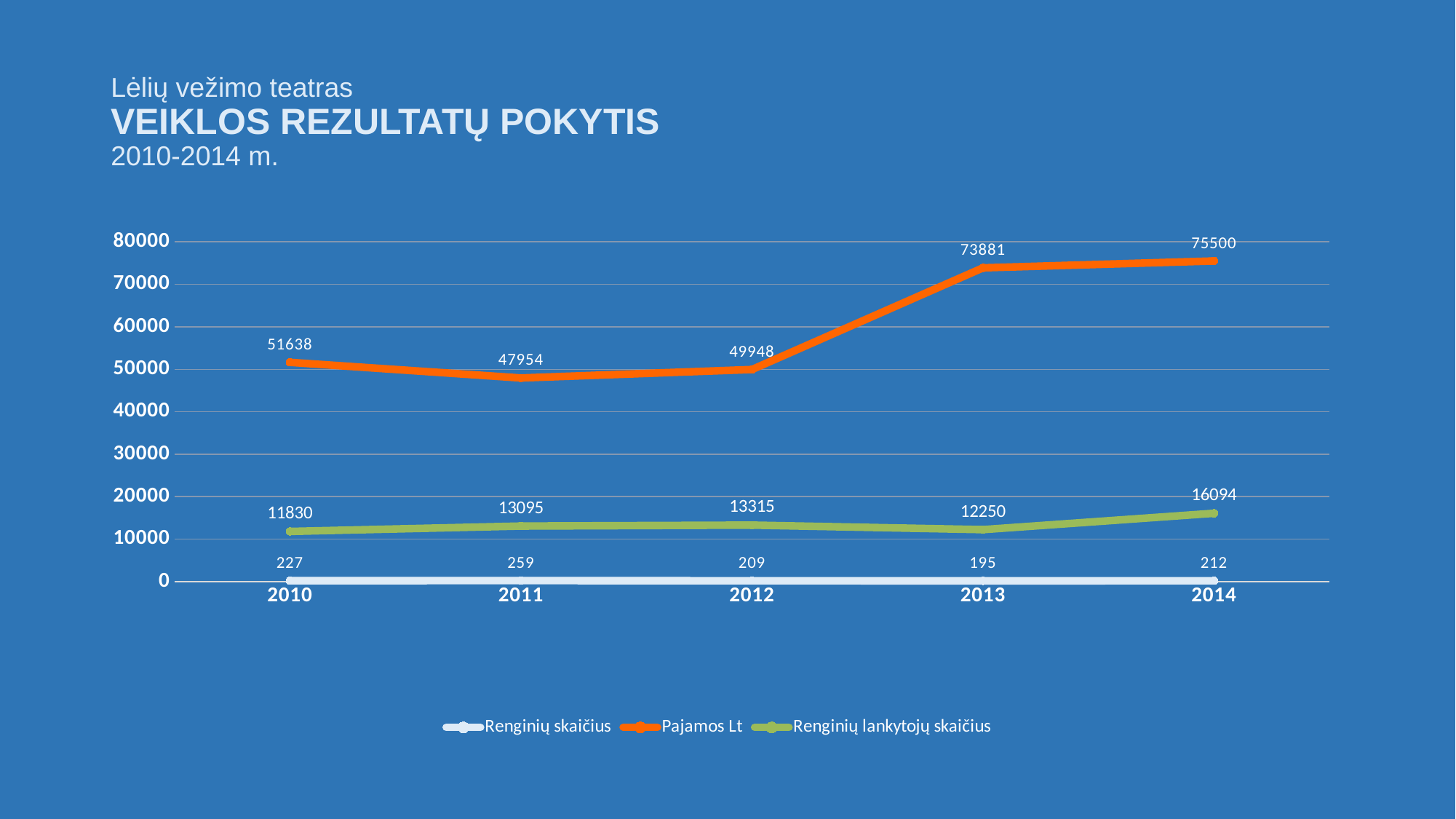
In which year is Renginių skaičius lowest? 2013 Which is larger: Renginių lankytojų skaičius in 2012 or in 2013? 2012 What kind of chart is shown on the slide? line chart Is the value of Pajamos Lt in 2011 greater or less than 50000? less In which year is Pajamos Lt highest? 2014 What is the value of Pajamos Lt in 2013? 73881 Does Pajamos Lt rise or fall from 2012 to 2014? rise What is the value of Renginių lankytojų skaičius in 2010? 11830 What is the value of Renginių skaičius in 2011? 259 How many series does the legend list? 3 What is the difference between Pajamos Lt in 2014 and in 2013? 1619 How many years are shown on the x axis? 5